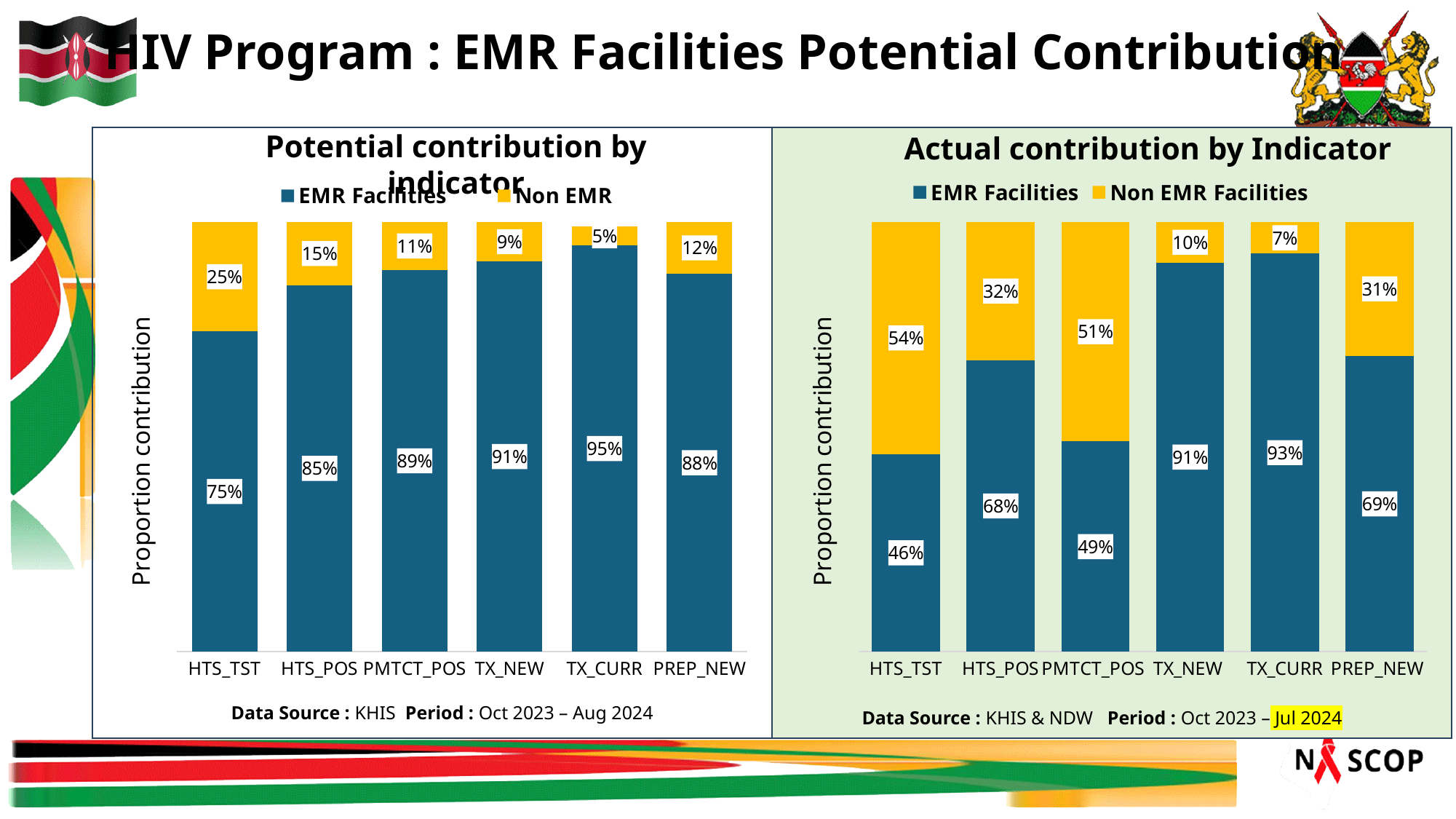
In the 'Actual contribution by Indicator' chart, what is the Non EMR Facilities value for HTS_POS? 32% In the 'Actual contribution by Indicator' chart, which indicator has the lowest EMR Facilities value? HTS_TST What kind of chart is the 'Actual contribution by Indicator' chart? Stacked bar chart In the 'Actual contribution by Indicator' chart, what is the total of the EMR Facilities and Non EMR Facilities values for PREP_NEW? 100% How many indicators are shown on the x axis of the 'Actual contribution by Indicator' chart? 6 How many series does the legend of the 'Potential contribution by indicator' chart list? 2 In the 'Potential contribution by indicator' chart, what is the EMR Facilities value for HTS_TST? 75% In the 'Potential contribution by indicator' chart, which is larger: the Non EMR value for HTS_TST or for PREP_NEW? HTS_TST In the 'Potential contribution by indicator' chart, which indicator has the highest EMR Facilities value? TX_CURR What is the data source stated below the 'Actual contribution by Indicator' chart? KHIS & NDW In the 'Actual contribution by Indicator' chart, what is the difference between the EMR Facilities values for TX_NEW and PMTCT_POS? 42% In the 'Potential contribution by indicator' chart, what is the Non EMR value for TX_CURR? 5%